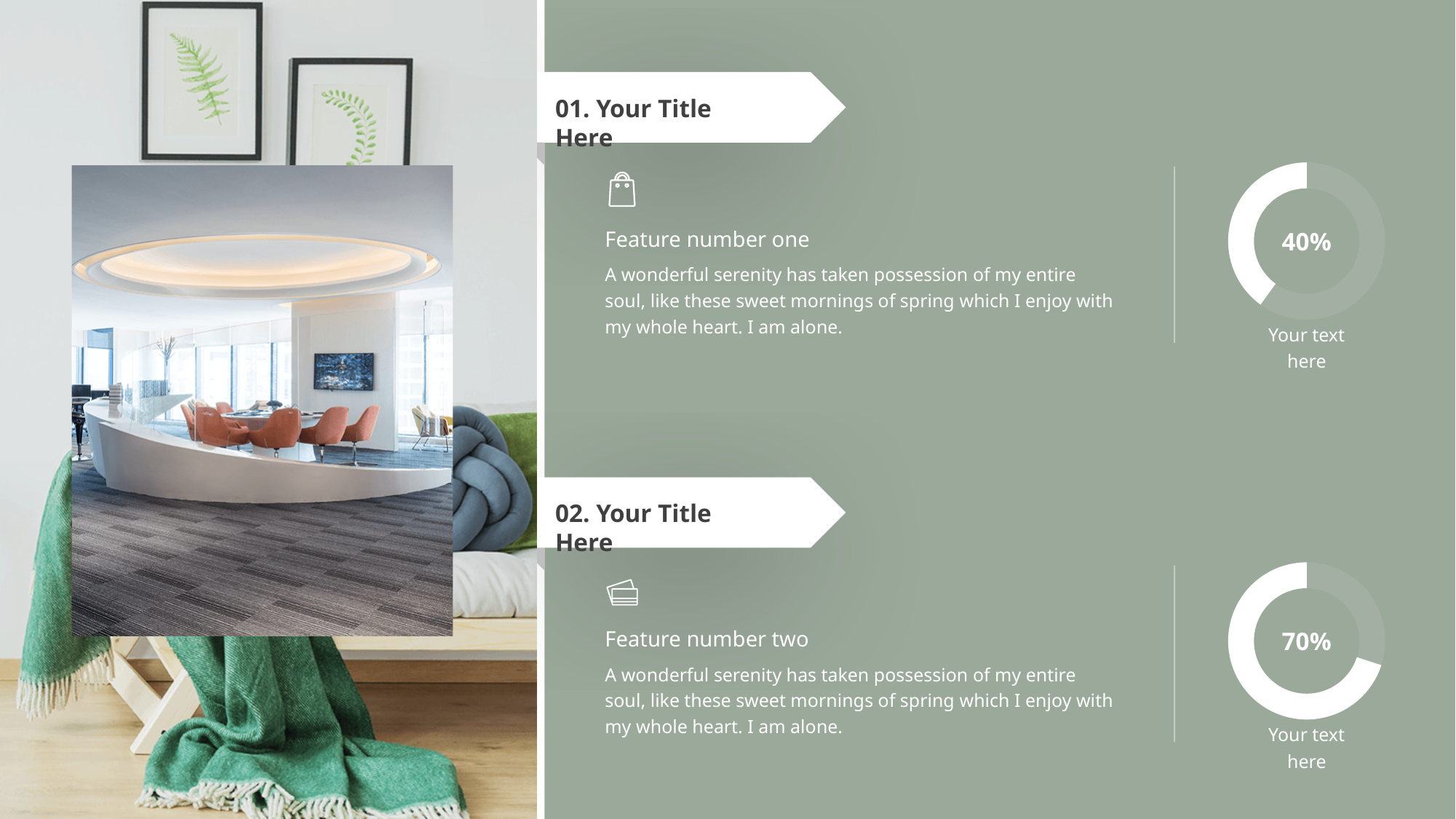
What caption text appears below each donut chart? Your text here How many donut charts are on the slide? 2 What percentage is shown in the centre of the top donut chart, next to "Feature number one"? 40% In the bottom donut chart, what share of the ring is filled in white? 70% Is the value shown in the bottom donut chart greater or less than 50%? greater Which donut chart shows the smaller percentage, the top one or the bottom one? the top one In the top donut chart, what share of the ring is filled in white? 40% Which donut chart shows the larger percentage, the top one or the bottom one? the bottom one What is the difference in percentage points between the bottom donut chart (70%) and the top donut chart (40%)? 30 percentage points Is the value shown in the top donut chart greater or less than 50%? less What percentage is shown in the centre of the bottom donut chart, next to "Feature number two"? 70% What kind of chart is used on the right side of the slide to show the 40% and 70% values? donut chart